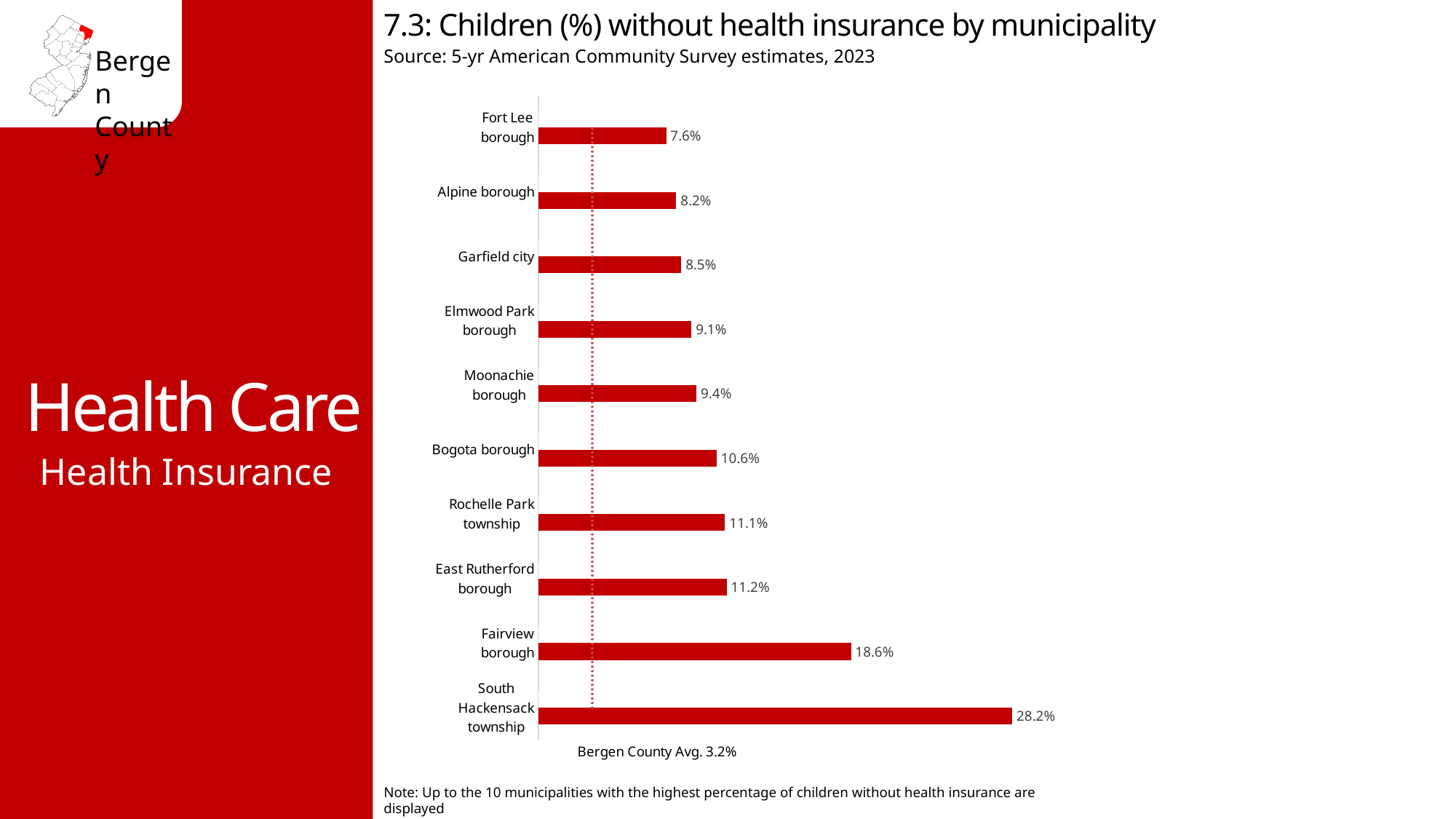
What is the title of the chart? 7.3: Children (%) without health insurance by municipality What is the Bergen County average shown on the chart? 3.2% What is the difference in percentage points between Alpine borough and Fort Lee borough? 0.6 Which has a higher percentage of children without health insurance, Bogota borough or Moonachie borough? Bogota borough How many municipalities are shown on the chart? 10 What percentage of children are without health insurance in South Hackensack township? 28.2% What is the value shown for Fairview borough? 18.6% Which municipality has the highest percentage of children without health insurance? South Hackensack township What kind of chart is shown on the slide? Bar chart What percentage is shown for Garfield city? 8.5% Which municipality has the lowest percentage of children without health insurance on the chart? Fort Lee borough What is the difference in percentage points between South Hackensack township and Fairview borough? 9.6